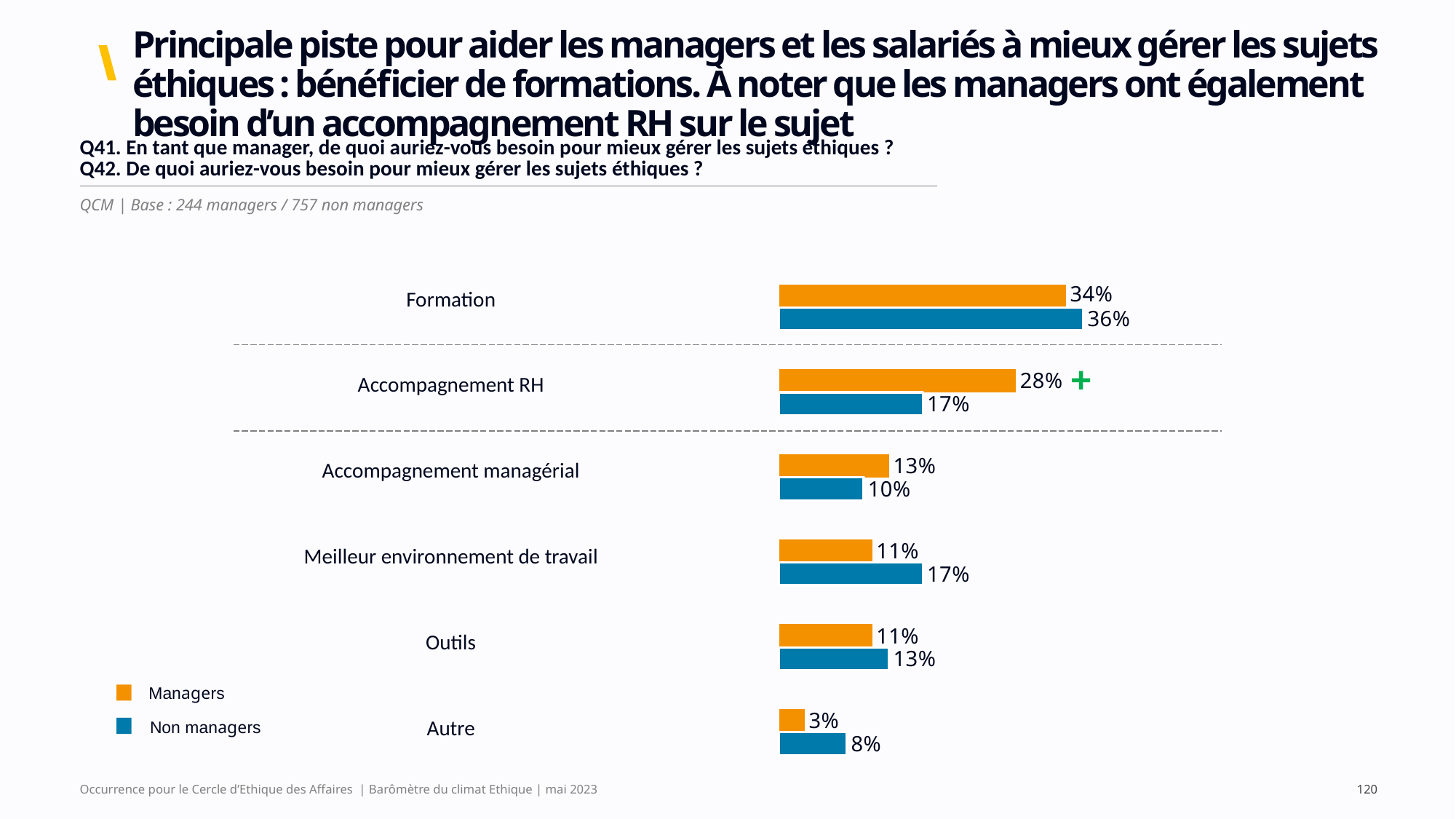
What is the value for Non managers for Accompagnement RH? 17% How many categories are shown in the chart? 6 What is the value for Managers for Formation? 34% What is the difference between the Managers and Non managers values for Accompagnement RH? 11% Which category has the highest value for Non managers? Formation What is the value for Managers for Autre? 3% Which category has the lowest value for Managers? Autre What is the difference between the Non managers and Managers values for Autre? 5% What kind of chart is shown on the slide? Bar chart How many series does the legend list? 2 Which colour represents the Managers series in the chart? Orange For Meilleur environnement de travail, which is larger: the Managers value or the Non managers value? Non managers